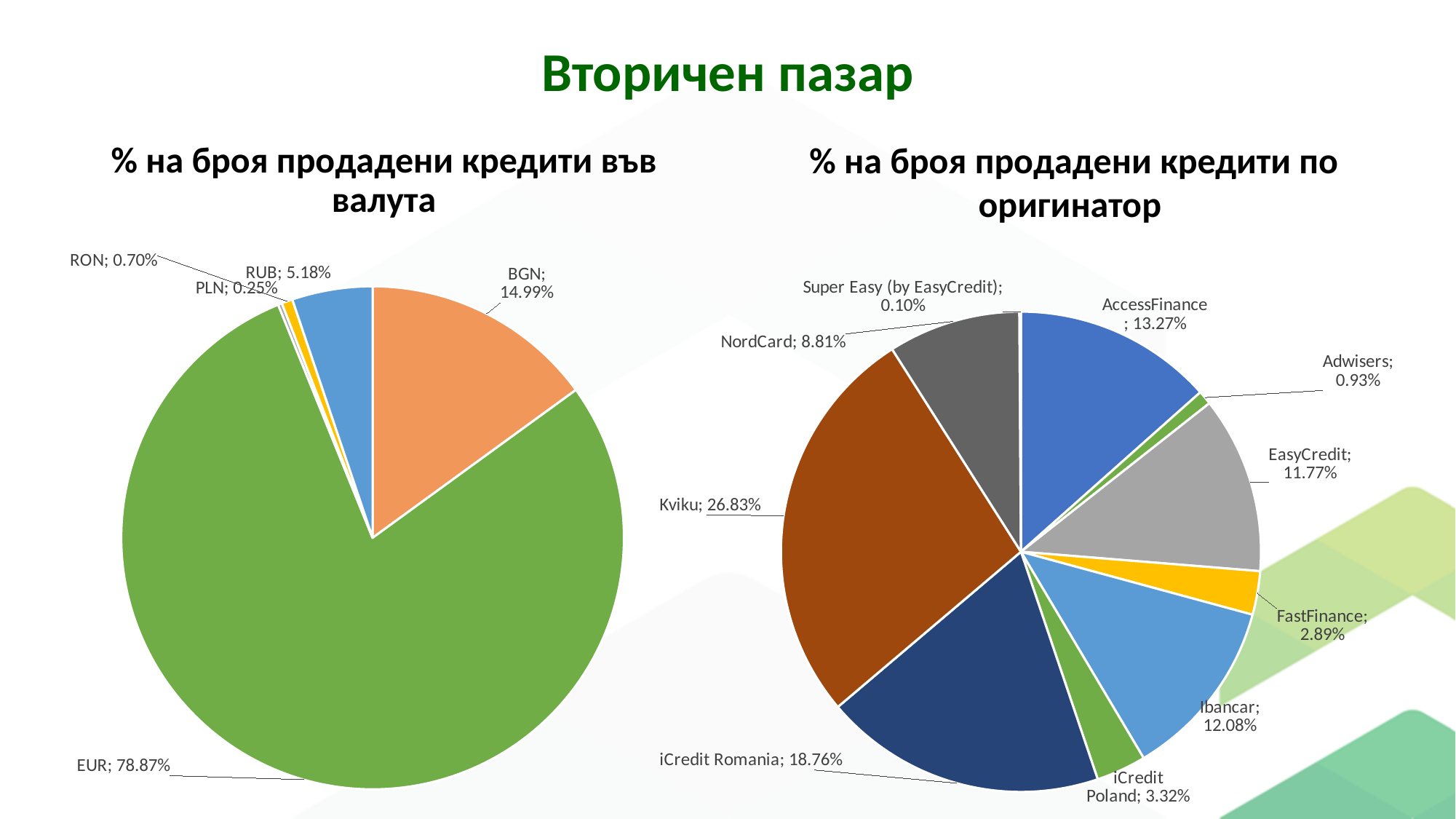
In the right chart (% на броя продадени кредити по оригинатор), which originator has the smallest share? Super Easy (by EasyCredit) What type of chart is used on the right side of the slide (% на броя продадени кредити по оригинатор)? Pie chart In the left chart (% на броя продадени кредити във валута), what share does EUR have? 78.87% In the right chart (% на броя продадени кредити по оригинатор), how many originators are shown? 10 In the right chart (% на броя продадени кредити по оригинатор), what is the difference between the iCredit Romania and Ibancar shares? 6.68% In the left chart (% на броя продадени кредити във валута), how many currencies are shown? 5 In the left chart (% на броя продадени кредити във валута), what is the difference between the BGN and RUB shares? 9.81% In the left chart (% на броя продадени кредити във валута), which currency has the largest share? EUR In the right chart (% на броя продадени кредити по оригинатор), which has a larger share, AccessFinance or EasyCredit? AccessFinance In the right chart (% на броя продадени кредити по оригинатор), which originator has the largest share? Kviku In the right chart (% на броя продадени кредити по оригинатор), what share does Kviku have? 26.83% In the left chart (% на броя продадени кредити във валута), which currency has the smallest share? PLN